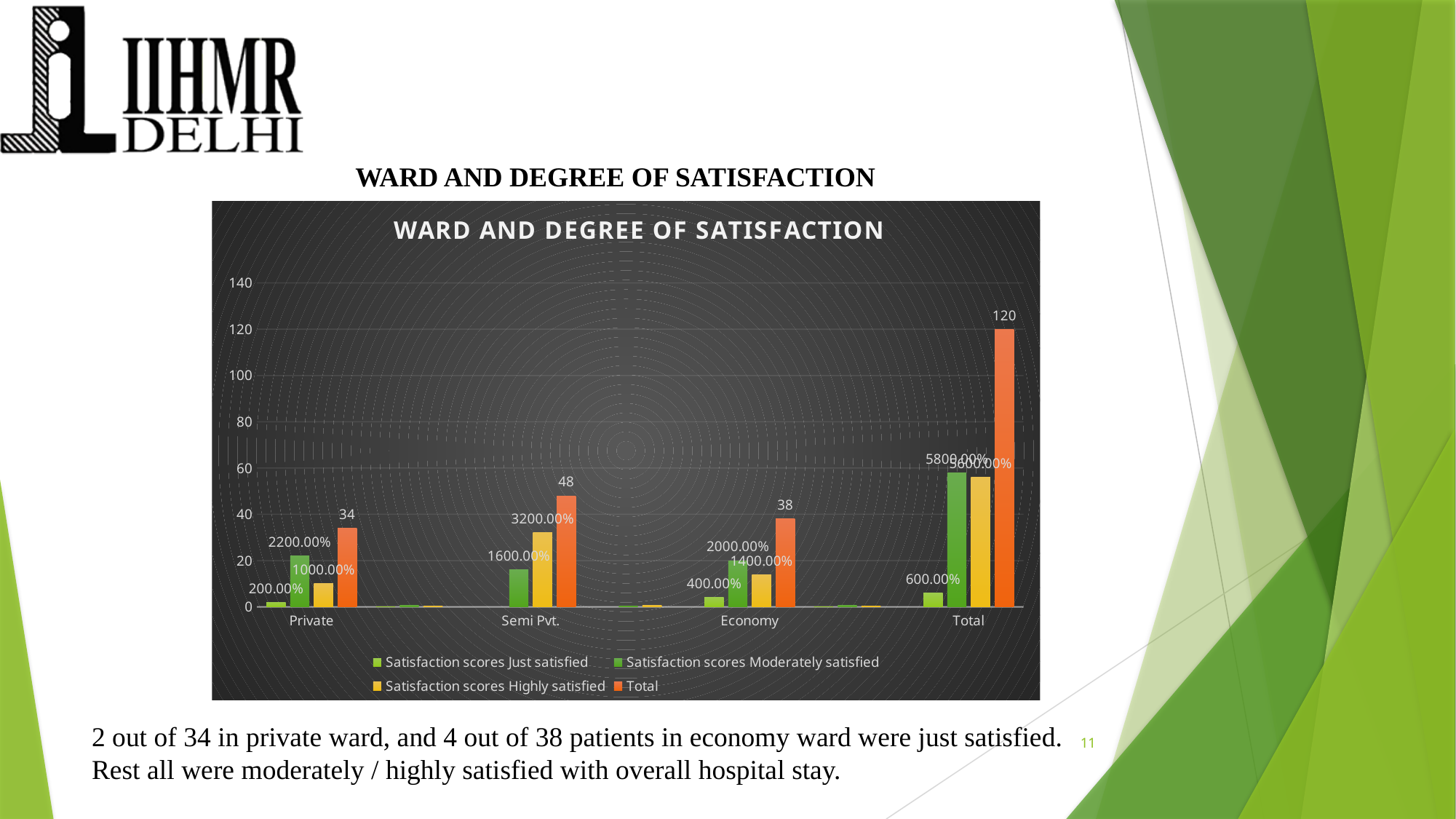
How many categories are shown on the x axis? 4 Which ward has the lowest Total value among Private, Semi Pvt. and Economy? Private What is the data label for Satisfaction scores Highly satisfied in the Semi Pvt. ward? 3200.00% What kind of chart is shown on the slide? bar chart What is the data label for Satisfaction scores Moderately satisfied in the Private ward? 2200.00% What is the Total value for the Semi Pvt. ward? 48 What is the Total value for the Economy ward? 38 Which category has the highest Total value? Total What is the difference between the Total values for Semi Pvt. and Economy? 10 How many series does the legend list? 4 What is the Total value for the Private ward? 34 What is the Total value for the Total category? 120